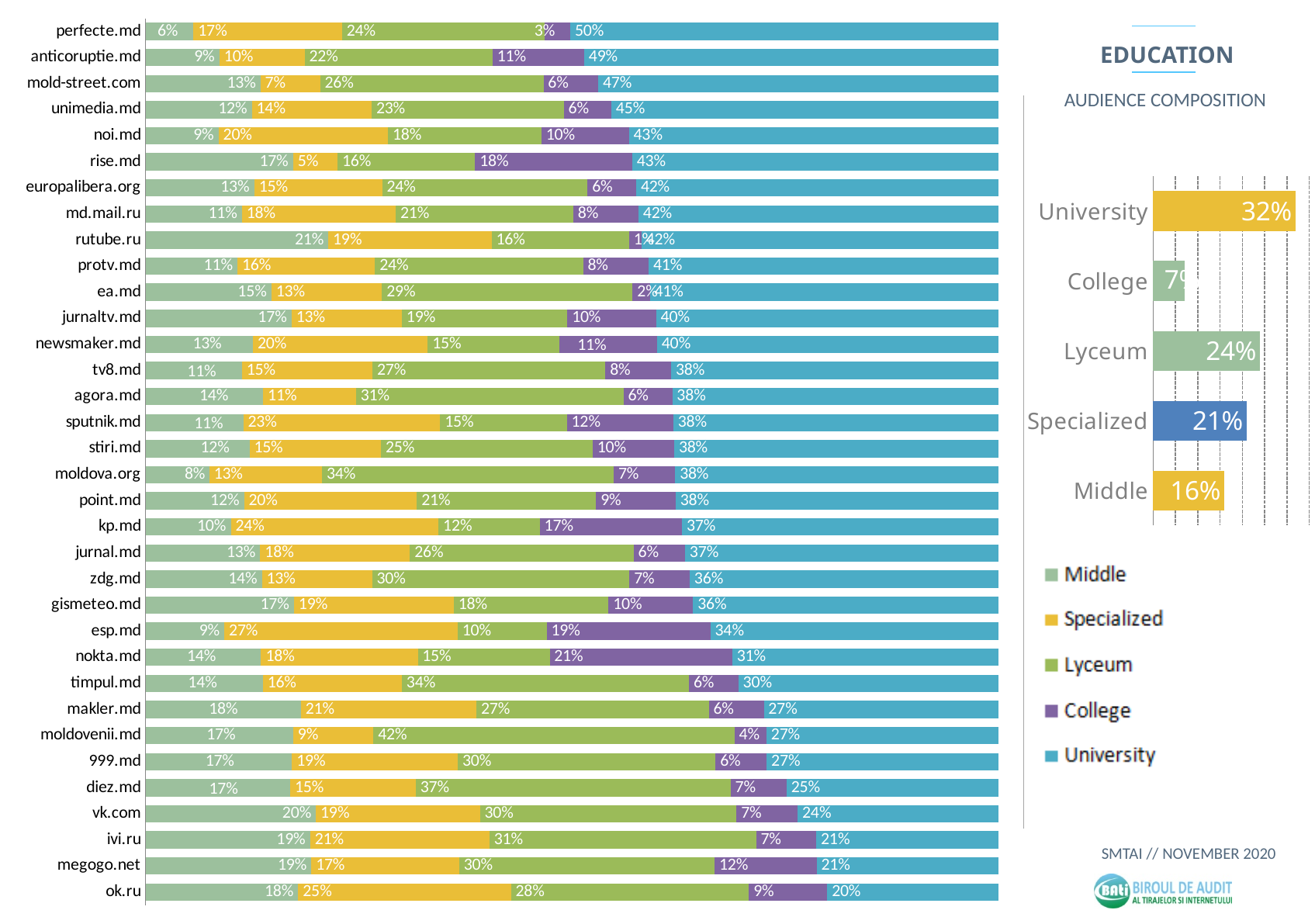
In the Audience Composition chart on the right, which category has the lowest value? College How many websites are listed in the left stacked bar chart? 34 In the left stacked bar chart, what is the College share for esp.md? 19% How many series does the legend of the left stacked bar chart list? 5 In the left stacked bar chart, which is larger: the Specialized share for kp.md or the Specialized share for rise.md? kp.md In the left stacked bar chart, what is the University share for perfecte.md? 50% In the left stacked bar chart, which website has the lowest University share? ok.ru In the left stacked bar chart, what is the difference between the University share of perfecte.md and that of ok.ru? 30 percentage points In the Audience Composition chart on the right, what is the difference between University and Lyceum? 8 percentage points In the left stacked bar chart, which website has the highest University share? perfecte.md In the Audience Composition chart on the right, what is the value for University? 32% In the left stacked bar chart, what is the Lyceum share for moldovenii.md? 42%